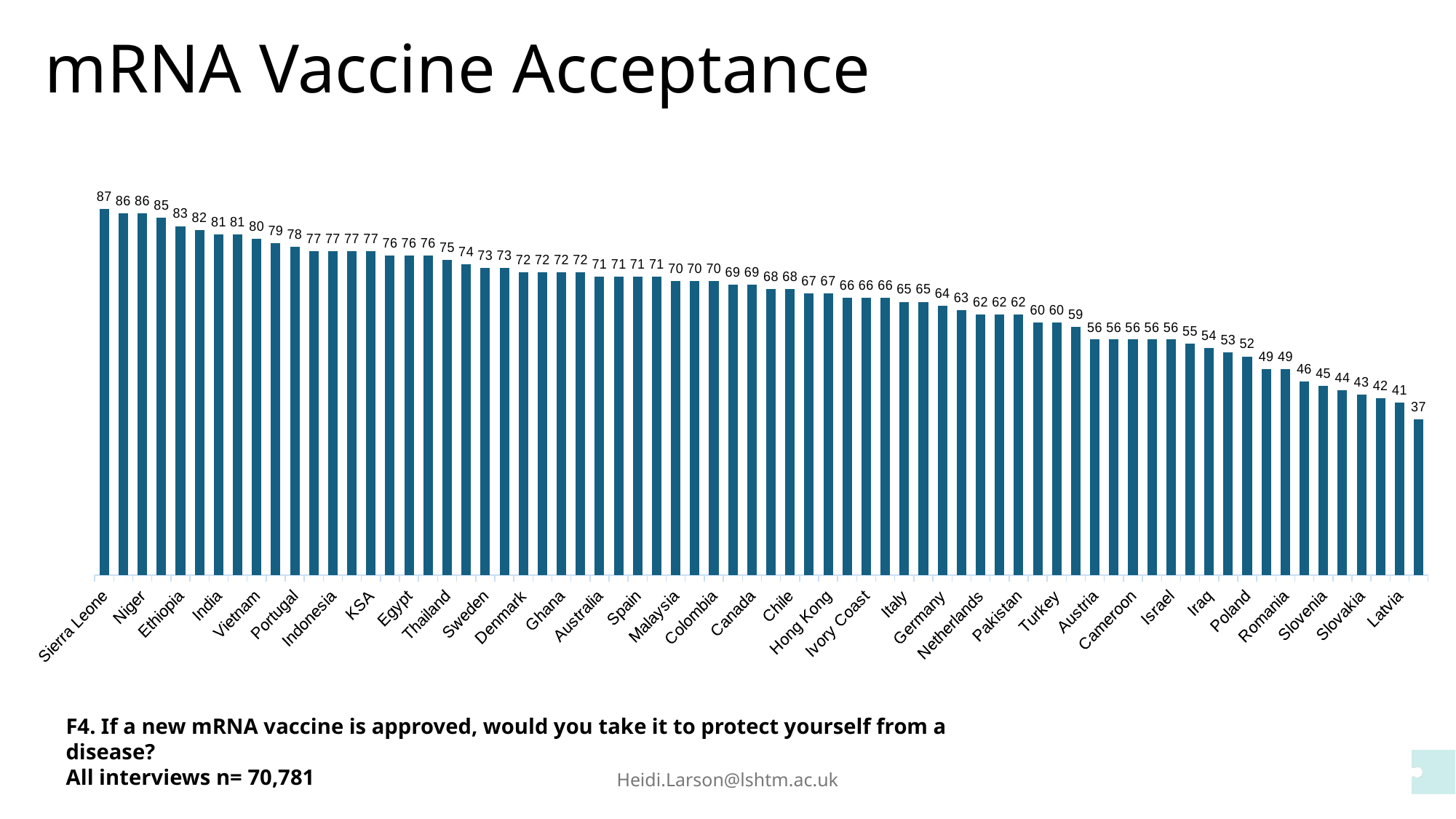
What is the highest value shown in the chart? 87 What is the value for Turkey? 60 Which country has the highest mRNA vaccine acceptance value? Sierra Leone What kind of chart is shown on the slide? bar chart What is the difference between the values for Sierra Leone and Latvia? 46 What is the value for Latvia? 41 What is the value for Vietnam? 80 Which has a larger value, Niger or Latvia? Niger Do the values rise or fall from left to right along the x axis? fall What is the lowest value shown in the chart? 37 What is the value for Sierra Leone? 87 What is the title of the chart on the slide? mRNA Vaccine Acceptance